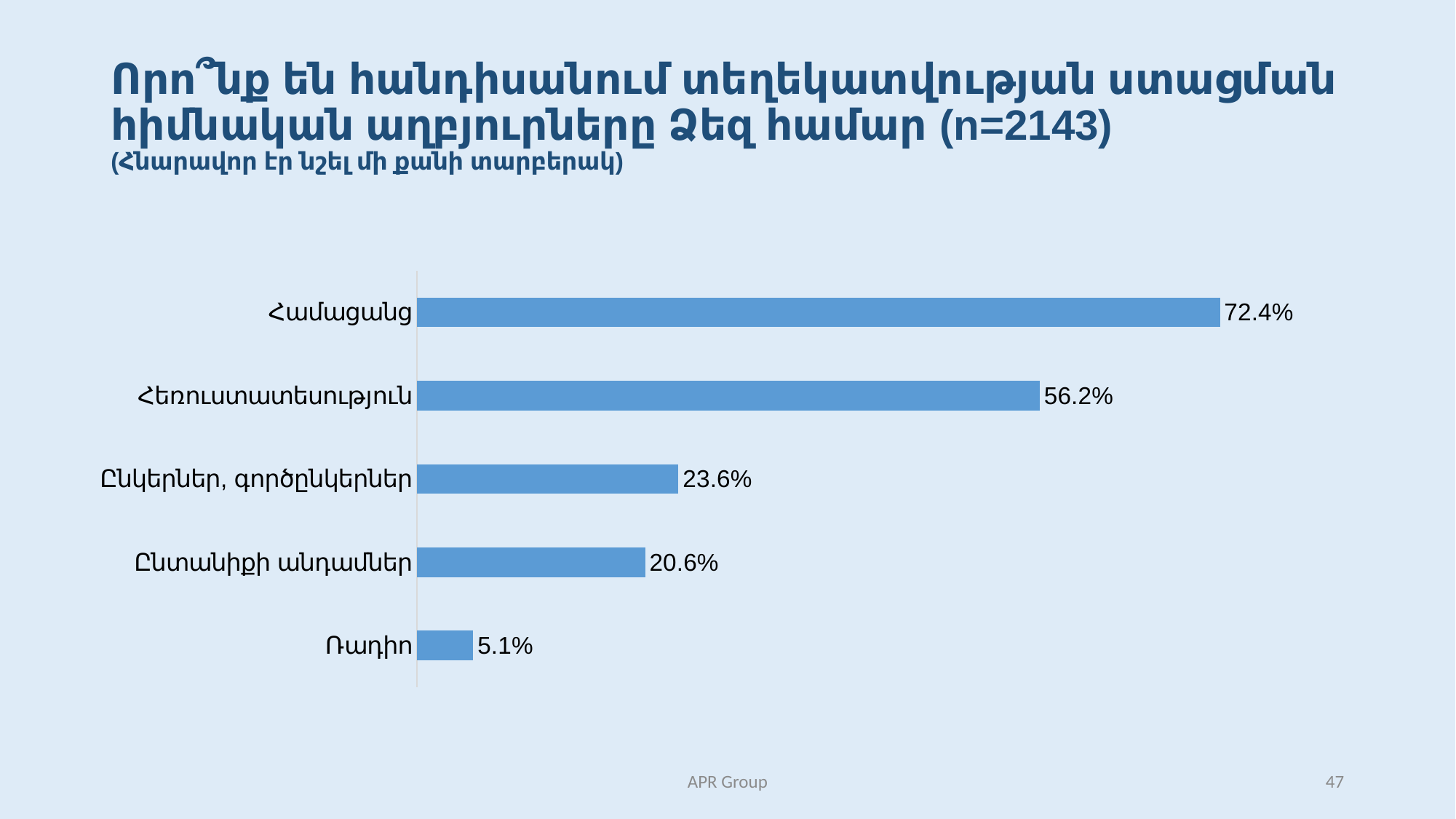
What is the difference between the values for Համացանց and Հեռուստատեսություն? 16.2% What is the value for Հեռուստատեսություն? 56.2% What is the value for Ընկերներ, գործընկերներ? 23.6% What is the value for Համացանց? 72.4% Which category has the highest value? Համացանց How many categories are shown in the chart? 5 What is the sample size (n) stated in the slide title? 2143 What is the difference between the values for Ընկերներ, գործընկերներ and Ընտանիքի անդամներ? 3.0% Which is larger, the value for Ընտանիքի անդամներ or the value for Ռադիո? Ընտանիքի անդամներ Which category has the lowest value? Ռադիո What kind of chart is shown on the slide? Bar chart What is the value for Ռադիո? 5.1%